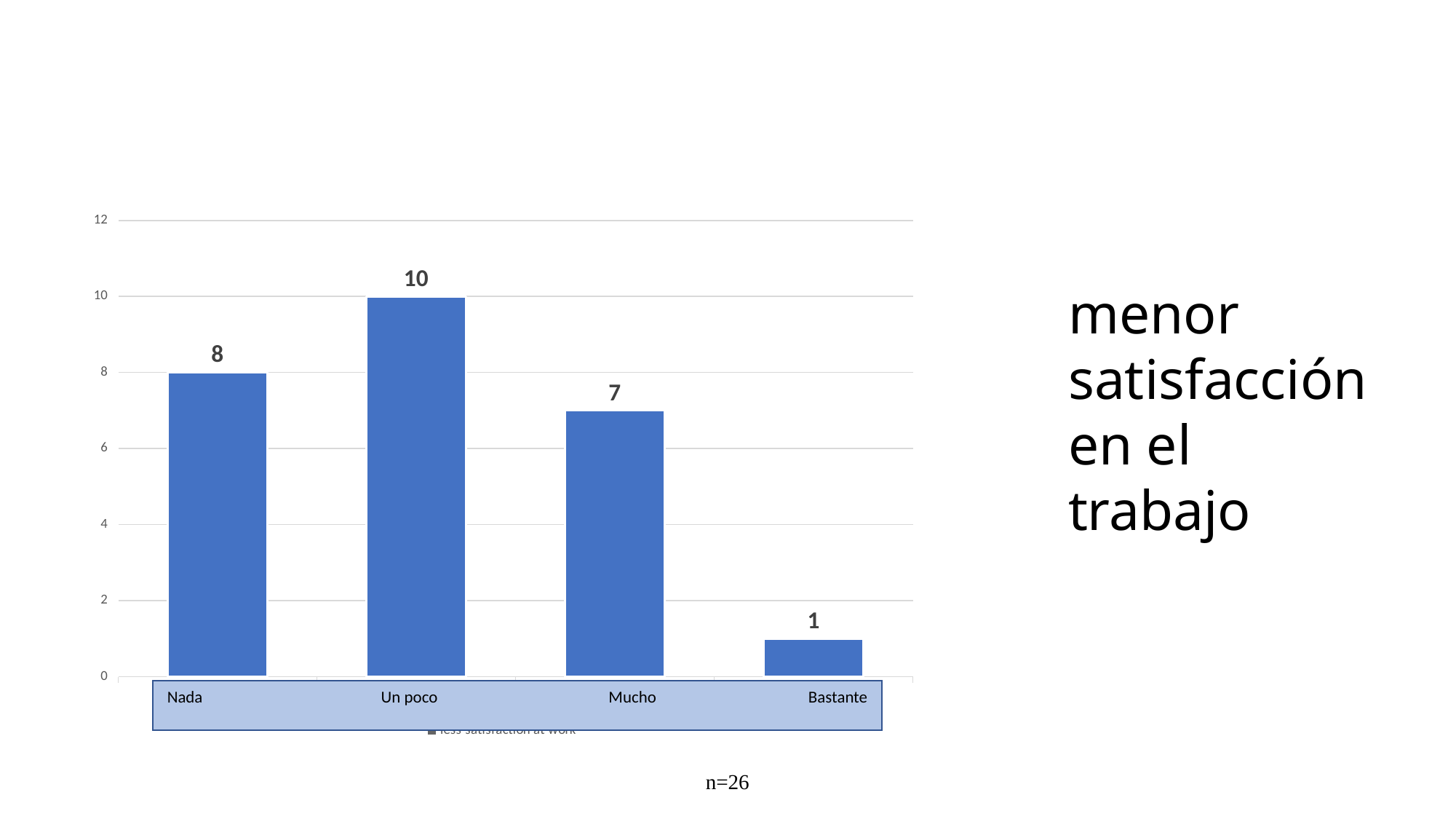
Which is larger, the value for Nada or the value for Mucho? Nada What kind of chart is shown on the slide? Bar chart What is the difference between the values for Un poco and Nada? 2 What is the difference between the values for Mucho and Bastante? 6 What is the value for Un poco? 10 What is the value for Mucho? 7 What sample size is noted below the chart? n=26 How many categories are shown on the x axis? 4 What is the value for Nada? 8 Which category has the lowest value? Bastante Which category has the highest value? Un poco What is the value for Bastante? 1